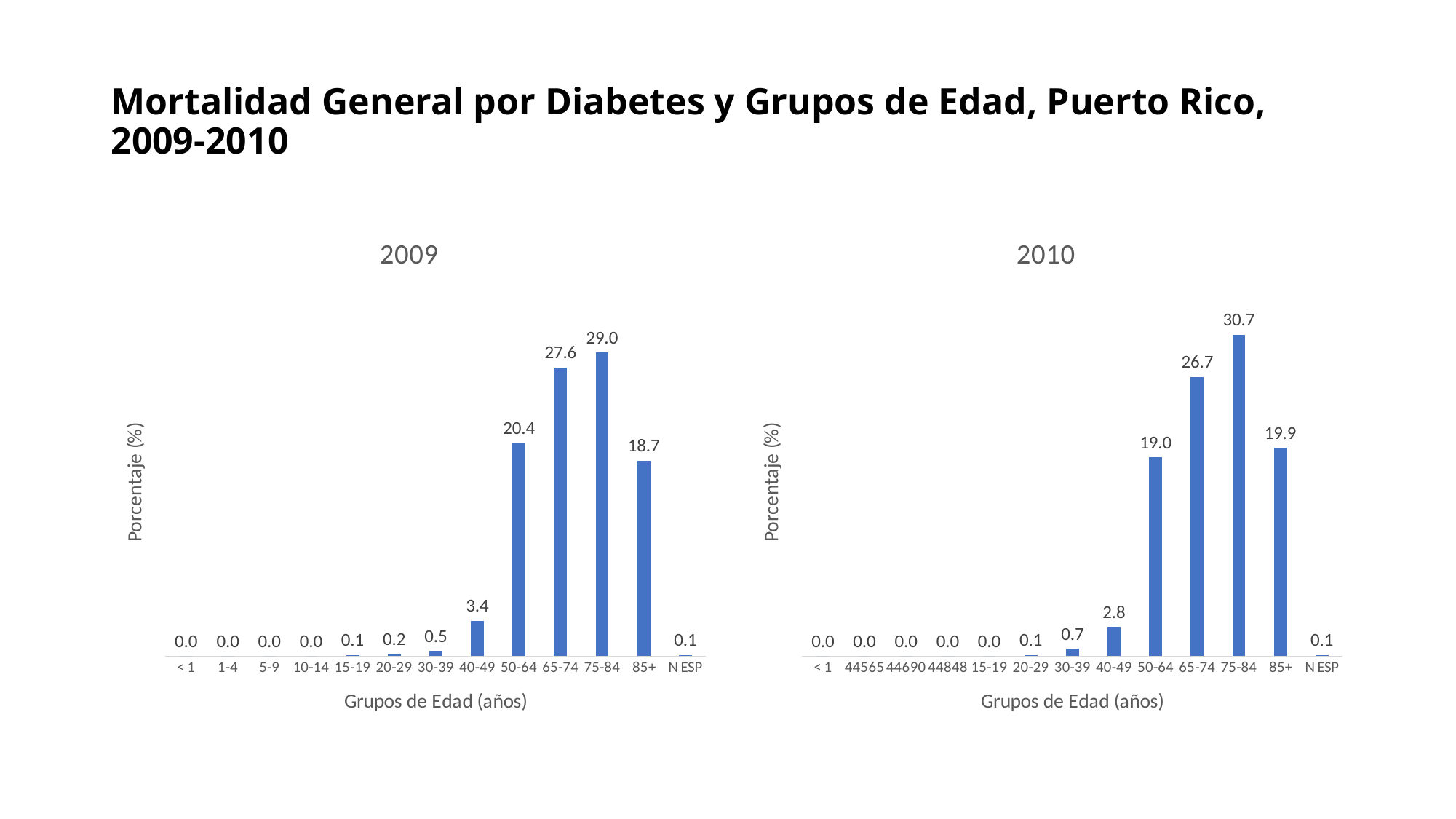
In the 2010 chart, which age group has the highest value? 75-84 In the 2010 chart, what is the value for the 50-64 age group? 19.0 In the 2009 chart, which is larger, the value for 50-64 or the value for 85+? 50-64 In the 2009 chart, what is the difference between the values for 65-74 and 50-64? 7.2 How many age-group categories are shown on the x axis of the 2009 chart? 13 What kind of chart is the 2010 chart? Bar chart In the 2009 chart, what is the value for the 75-84 age group? 29.0 What is the y-axis label of the 2009 chart? Porcentaje (%) In the 2009 chart, which age group has the highest value? 75-84 In the 2010 chart, what is the difference between the values for 75-84 and 65-74? 4.0 In the 2009 chart, what is the value for the 40-49 age group? 3.4 In the 2010 chart, which is larger, the value for 85+ or the value for 50-64? 85+